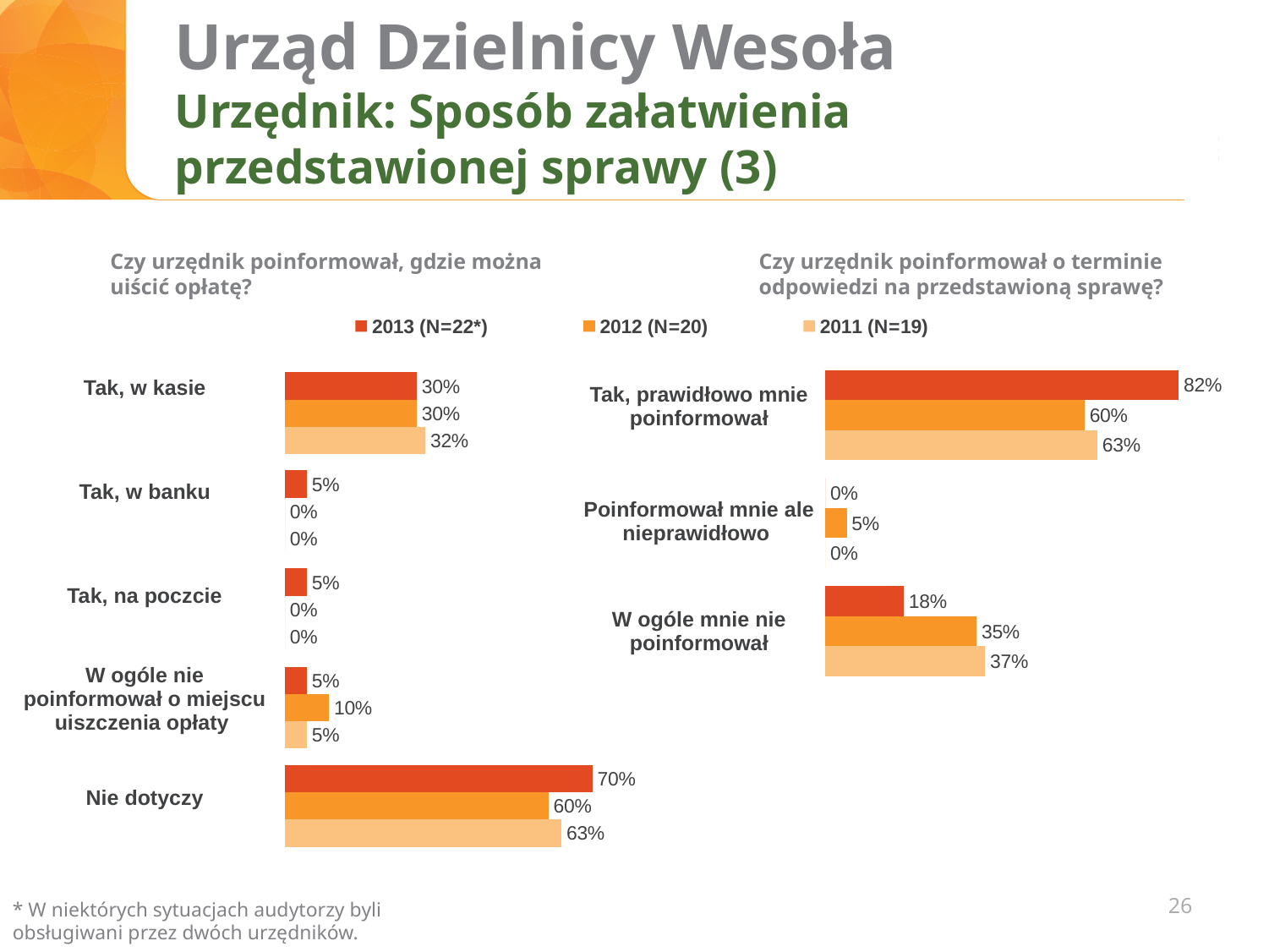
How many series does the legend list? 3 In the right chart ("Czy urzędnik poinformował o terminie odpowiedzi na przedstawioną sprawę?"), what is the 2013 value for "Tak, prawidłowo mnie poinformował"? 82% In the right chart, which is larger for "W ogóle mnie nie poinformował": the 2013 value or the 2012 value? 2012 In the right chart, what is the difference between the 2013 and 2012 values for "Tak, prawidłowo mnie poinformował"? 22 percentage points In the left chart, which category has the highest 2013 value? Nie dotyczy In the left chart ("Czy urzędnik poinformował, gdzie można uiścić opłatę?"), what is the 2013 value for "Nie dotyczy"? 70% What type of chart is used on this slide? Bar chart In the left chart, what is the 2012 value for "W ogóle nie poinformował o miejscu uiszczenia opłaty"? 10% In the right chart, which category has the lowest 2012 value? Poinformował mnie ale nieprawidłowo How many categories does the left chart show? 5 In the right chart, what is the 2011 value for "W ogóle mnie nie poinformował"? 37% In the left chart, what is the difference between the 2013 and 2011 values for "Nie dotyczy"? 7 percentage points